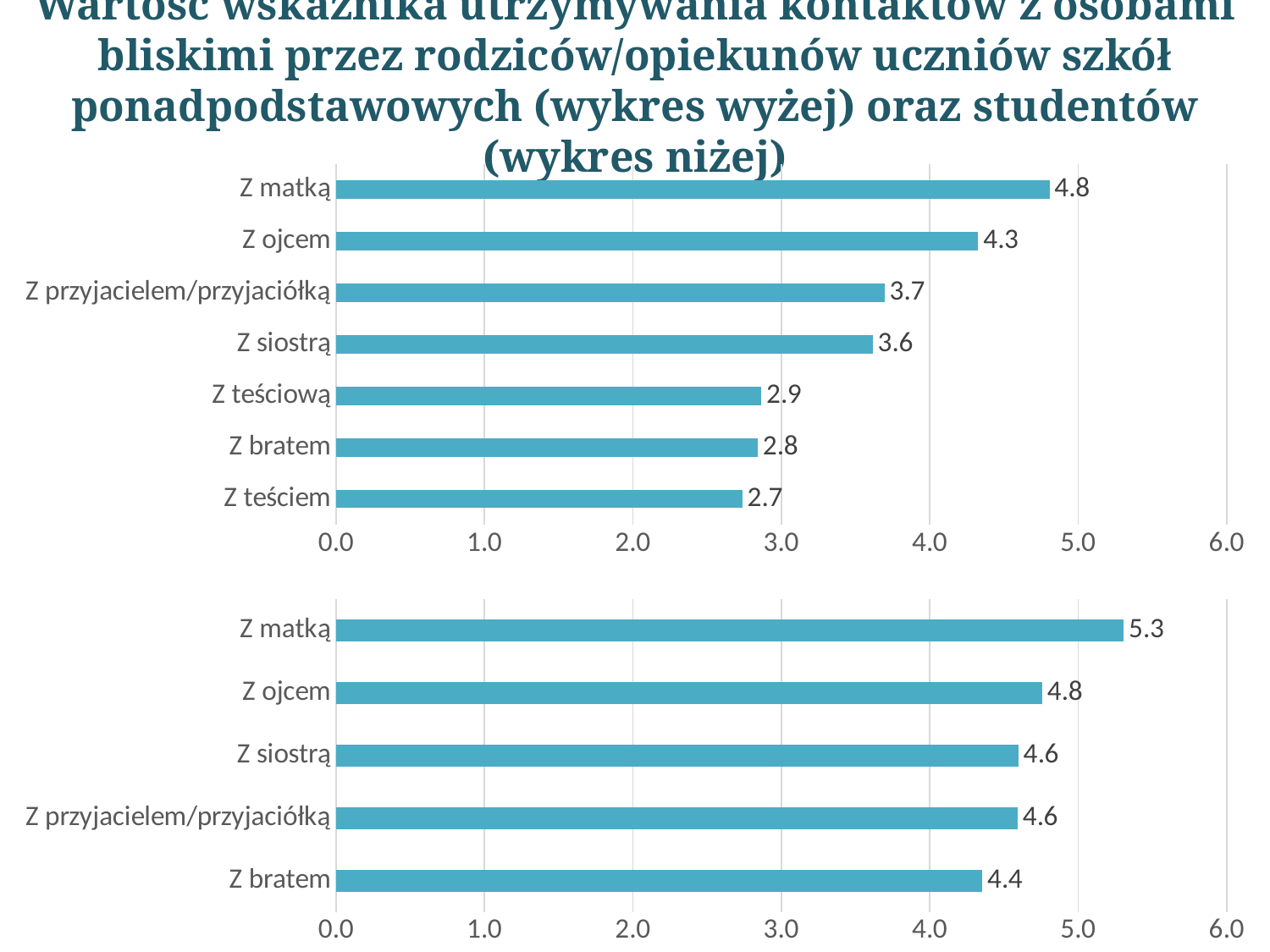
In the upper chart, which category has the lowest value? Z teściem What kind of chart is the lower chart? Bar chart In the lower chart, is the value for "Z ojcem" greater or less than 5.0? less In the upper chart, what is the value for "Z matką"? 4.8 In the upper chart, which is larger: the value for "Z przyjacielem/przyjaciółką" or the value for "Z bratem"? Z przyjacielem/przyjaciółką In the lower chart, what is the difference between the values for "Z matką" and "Z bratem"? 0.9 In the lower chart, which category has the highest value? Z matką In the lower chart, what is the value for "Z bratem"? 4.4 In the upper chart, what is the value for "Z teściową"? 2.9 How many categories are shown in the upper chart? 7 In the upper chart, what is the difference between the values for "Z matką" and "Z ojcem"? 0.5 How many categories are shown in the lower chart? 5